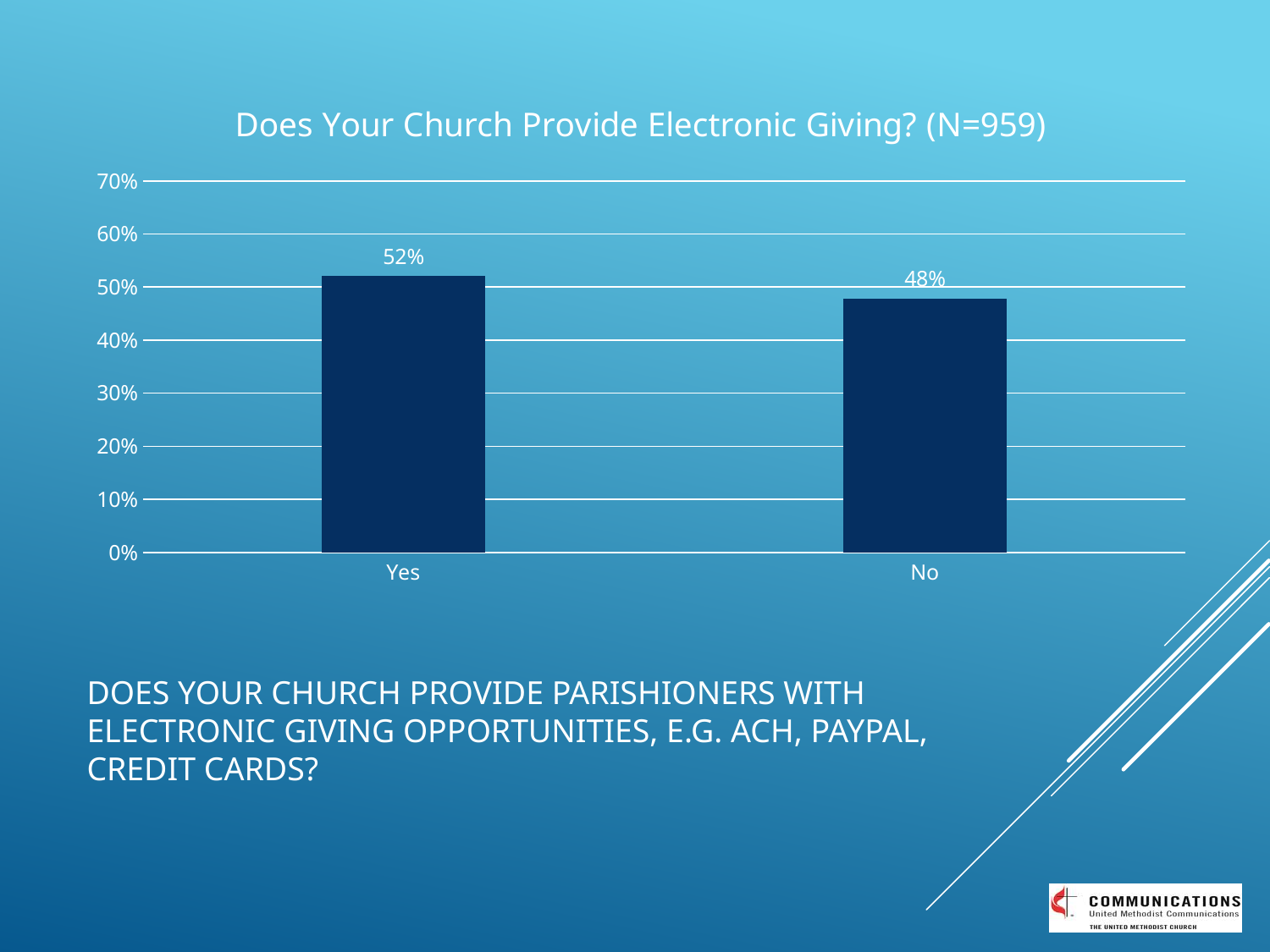
Is the value for Yes larger than the value for No? Yes How many categories are shown on the chart? 2 What percentage of churches answered No to providing electronic giving? 48% What is the title of the chart? Does Your Church Provide Electronic Giving? (N=959) Which category has the higher value, Yes or No? Yes Is the value for No greater or less than 50%? less Which category has the lower value? No What is the highest value shown on the y-axis? 70% What kind of chart is shown on the slide? Bar chart What is the difference between the Yes and No percentages? 4% What percentage of churches answered Yes to providing electronic giving? 52% Is the value for Yes greater or less than 50%? greater